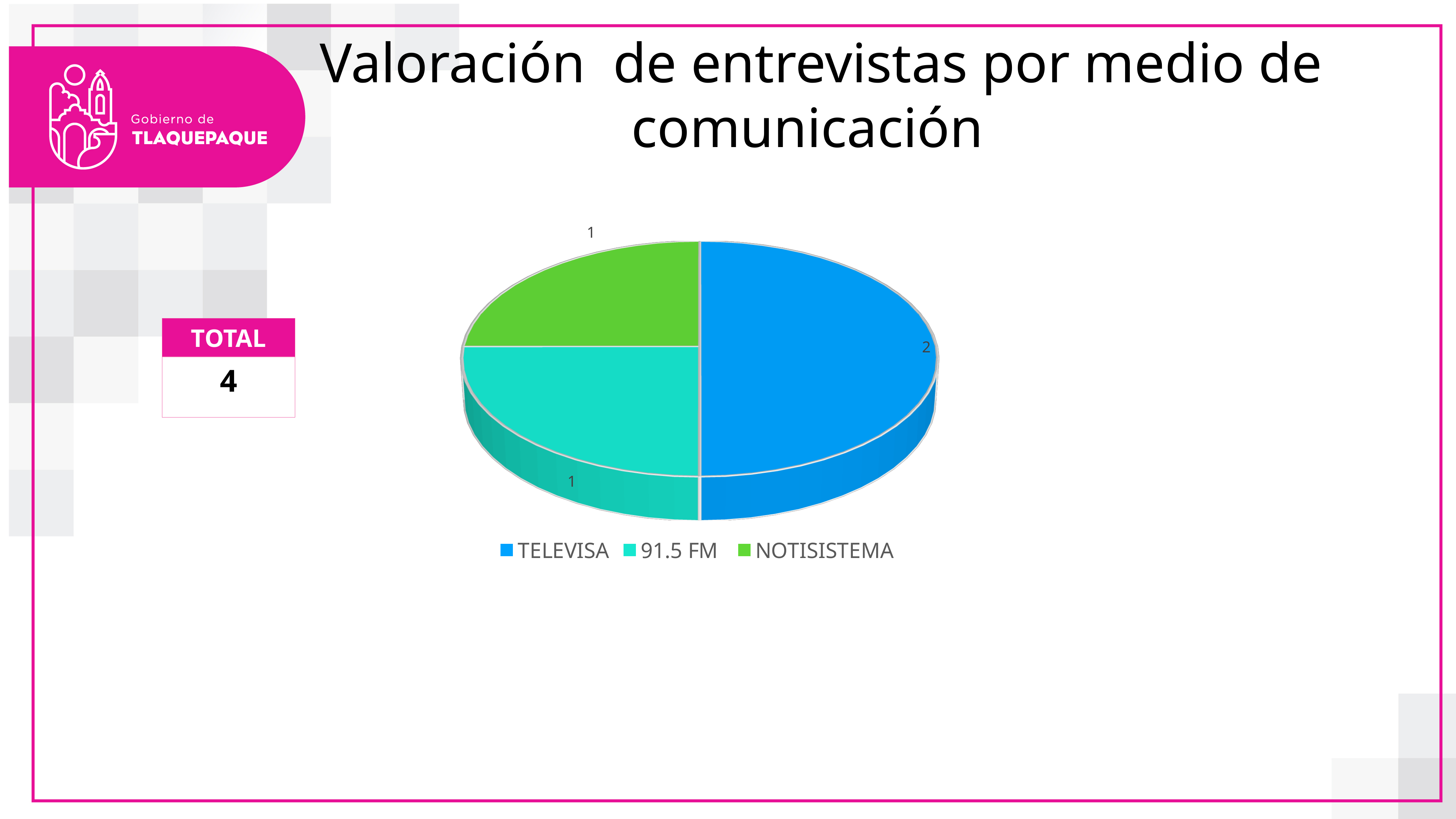
Which is larger, the value for TELEVISA or the value for NOTISISTEMA? TELEVISA What is the total of all slices in the pie chart? 4 What is the value for 91.5 FM? 1 What colour is the NOTISISTEMA slice? Green What is the value for TELEVISA? 2 Which medium has the largest slice of the pie? TELEVISA What kind of chart is shown on the slide? Pie chart How many slices does the pie chart have? 3 What share of the pie does TELEVISA represent? 50% How many entries does the legend list? 3 What is the difference between the values for TELEVISA and 91.5 FM? 1 What is the value for NOTISISTEMA? 1